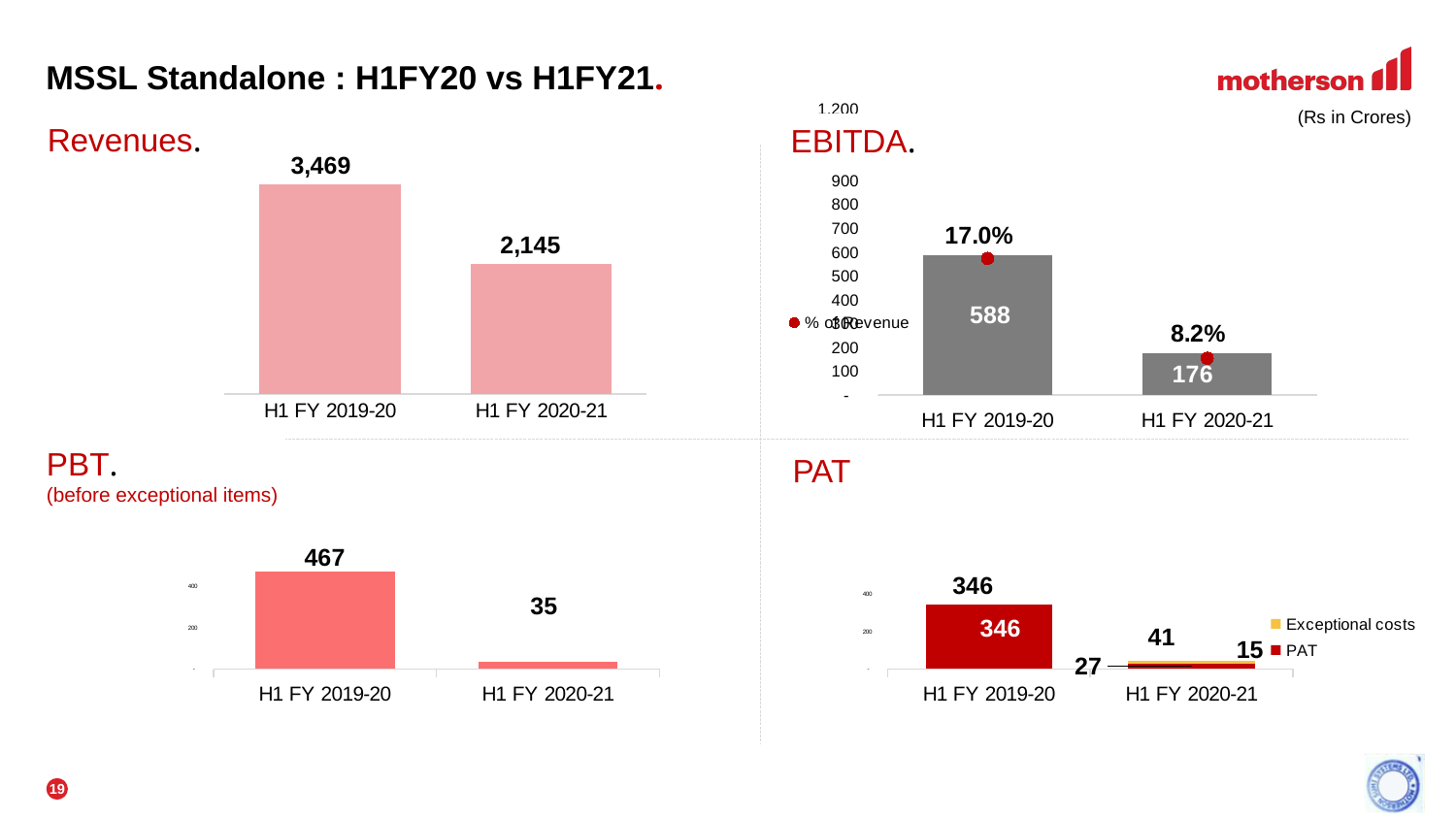
How many series does the legend of the PAT chart list? 2 In the PBT chart, what is the difference between the H1 FY 2019-20 and H1 FY 2020-21 values? 432 In the PBT chart, what is the value for H1 FY 2020-21? 35 In the EBITDA chart, which period has the higher EBITDA? H1 FY 2019-20 In the Revenues chart, what is the value for H1 FY 2020-21? 2,145 In the EBITDA chart, what is the EBITDA value for H1 FY 2020-21? 176 What kind of chart is the Revenues chart? Bar chart In the Revenues chart, what is the difference between the H1 FY 2019-20 and H1 FY 2020-21 values? 1,324 In the Revenues chart, what is the value for H1 FY 2019-20? 3,469 In the PAT chart, what is the total of the stacked bar for H1 FY 2020-21? 41 In the EBITDA chart, what is the % of Revenue for H1 FY 2019-20? 17.0% In the PAT chart, what is the PAT value for H1 FY 2020-21? 27